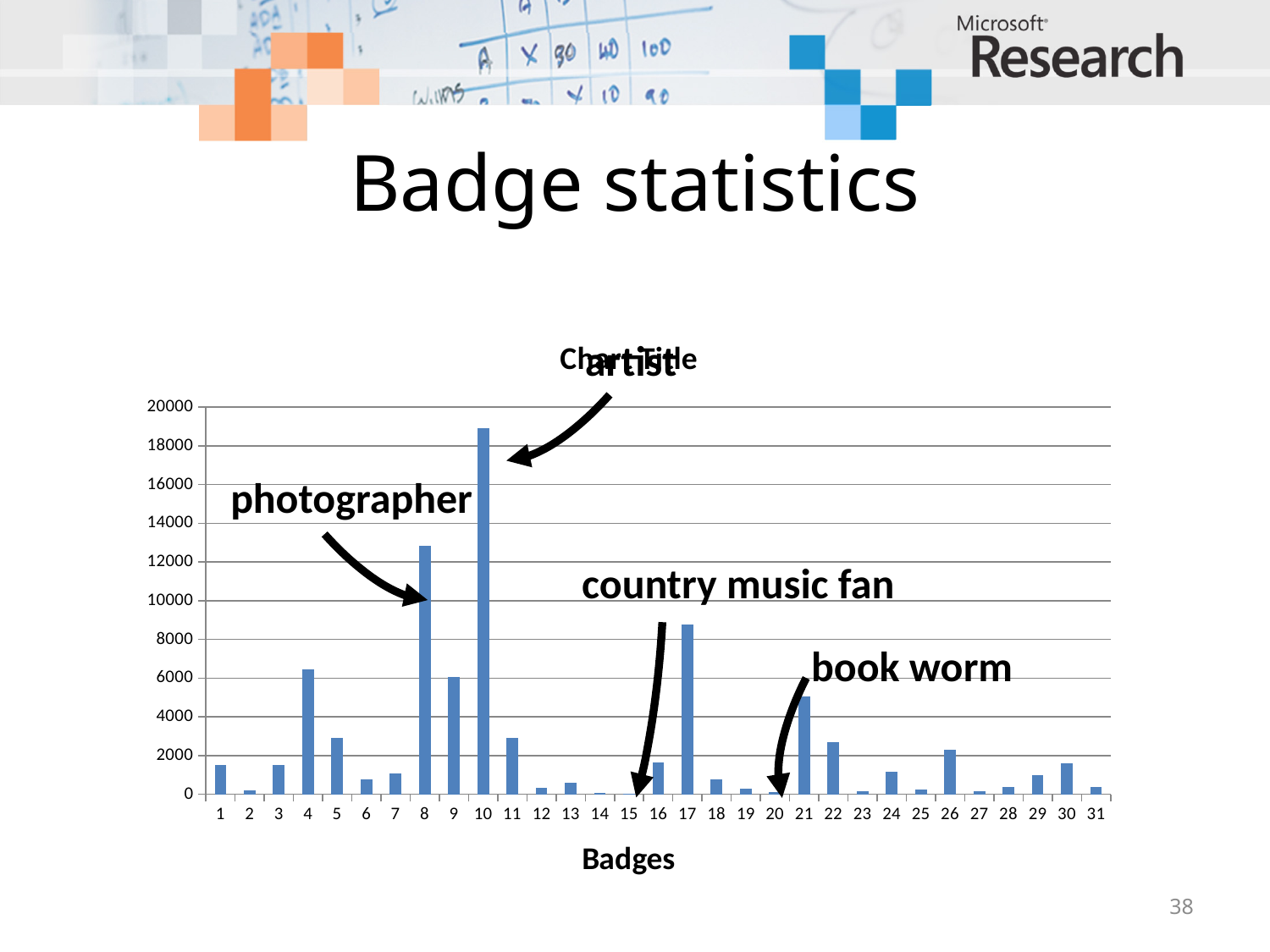
Is the value for badge 17 greater or less than 8000? greater Is the value for badge 10 greater or less than 18000? greater What is the title of the x axis? Badges Which badge number has the highest bar? 10 How many badges (categories) are plotted on the x axis? 31 Which has the larger value, badge 8 or badge 10? badge 10 What kind of chart is shown on the slide? bar chart Is the value for badge 1 greater or less than 2000? less Which has the larger value, badge 17 or badge 21? badge 17 Which badge number is annotated as "photographer"? 8